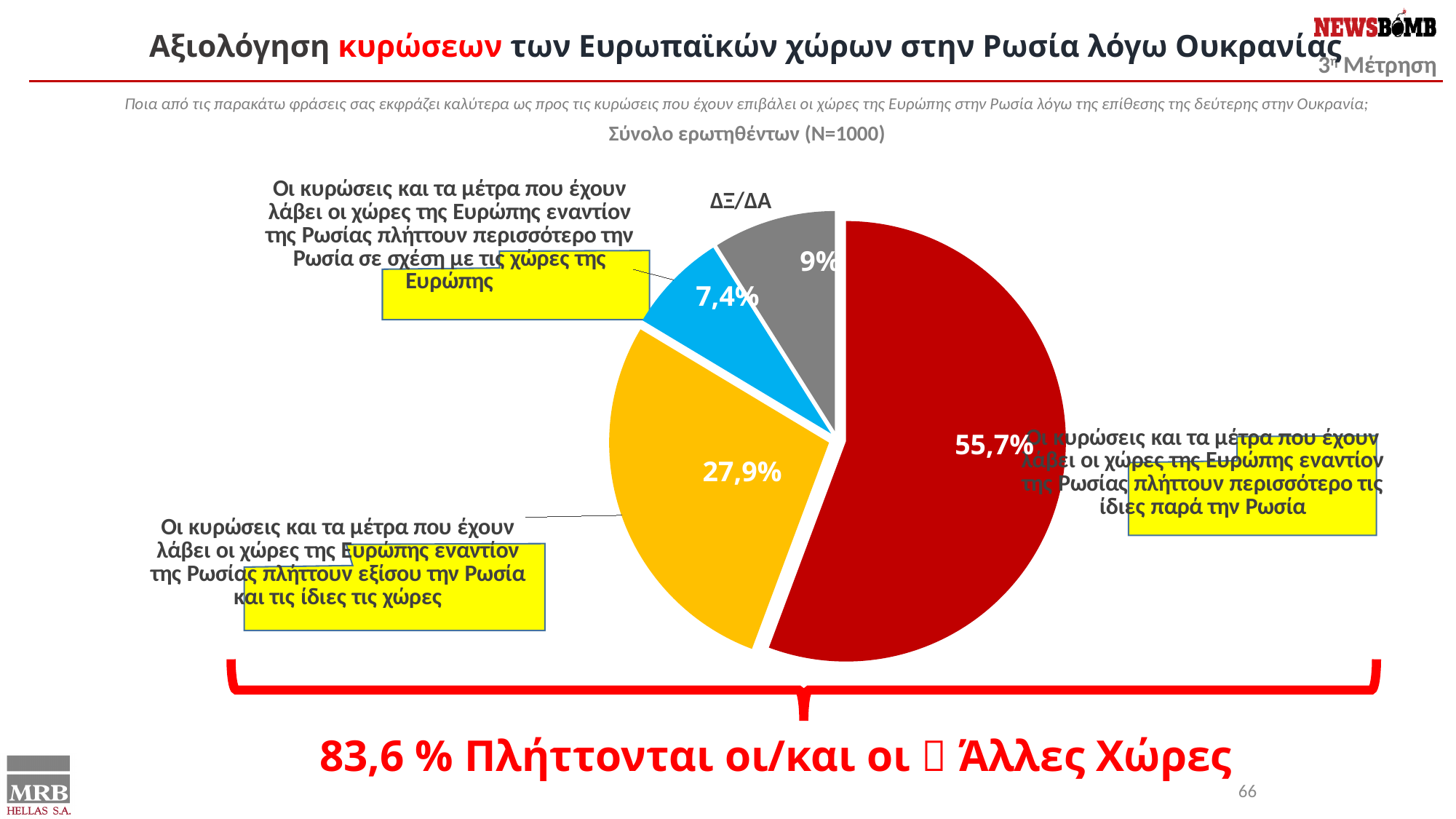
Which response has the smallest share of the pie? Οι κυρώσεις πλήττουν περισσότερο την Ρωσία (7,4%) Which is larger: the ΔΞ/ΔΑ slice or the slice for sanctions hurting Russia more? ΔΞ/ΔΑ (9%) Which response has the largest share of the pie? Οι κυρώσεις πλήττουν περισσότερο τις ίδιες παρά την Ρωσία (55,7%) What is the combined percentage highlighted below the chart for respondents who said the European countries are hurt (alone or equally)? 83,6 % What type of chart is shown on the slide? pie chart What percentage of respondents said the sanctions hurt Russia more than the European countries ("πλήττουν περισσότερο την Ρωσία")? 7,4% What percentage of respondents said the sanctions hurt the European countries themselves more than Russia ("πλήττουν περισσότερο τις ίδιες παρά την Ρωσία")? 55,7% What percentage of respondents answered ΔΞ/ΔΑ (don't know / no answer)? 9% What percentage of respondents said the sanctions hurt Russia and the European countries equally ("πλήττουν εξίσου")? 27,9% How many slices does the pie chart have? 4 What is the difference in percentage points between the 55,7% slice and the 27,9% slice? 27,8 What colour is the slice representing 27,9%? orange